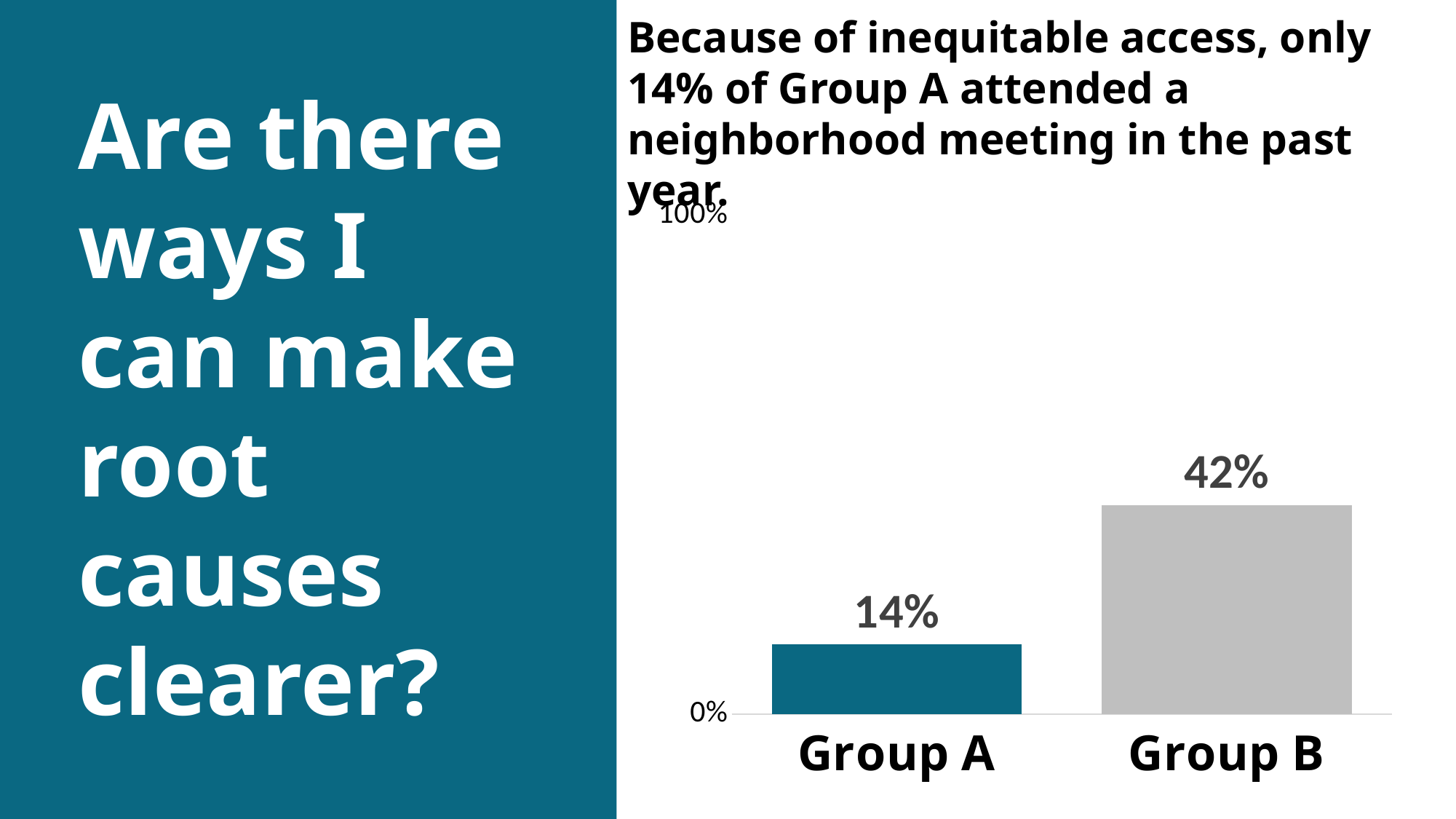
How many categories are shown on the chart? 2 Which group has the highest value? Group B Which is larger, the value for Group A or the value for Group B? Group B What is the difference between the values for Group B and Group A? 28% Which group has the lowest value? Group A What is the value for Group A? 14% What kind of chart is shown on the slide? Bar chart What colour is the bar for Group A? Teal What is the highest value shown on the chart's vertical axis? 100% What is the value for Group B? 42%